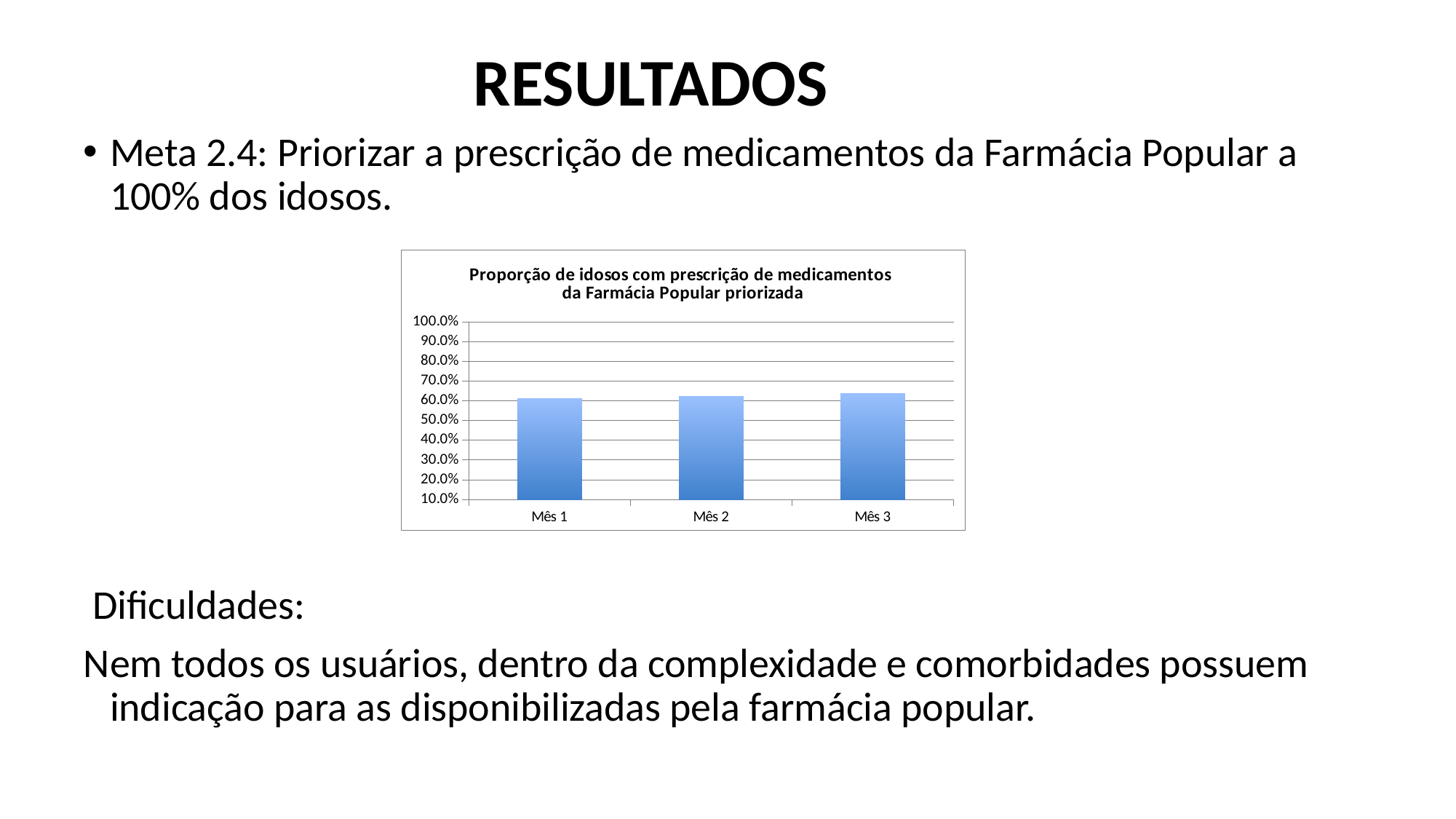
Is the value for Mês 2 greater or less than 70.0%? less Do the values rise or fall from Mês 1 to Mês 3? rise Is the value for Mês 1 greater or less than 70.0%? less How many categories (months) are shown on the x axis of the chart? 3 What kind of chart is shown on the slide? bar chart What is the highest value shown on the chart's y axis? 100.0% Is the value for Mês 3 greater or less than 80.0%? less What is the title of the chart? Proporção de idosos com prescrição de medicamentos da Farmácia Popular priorizada